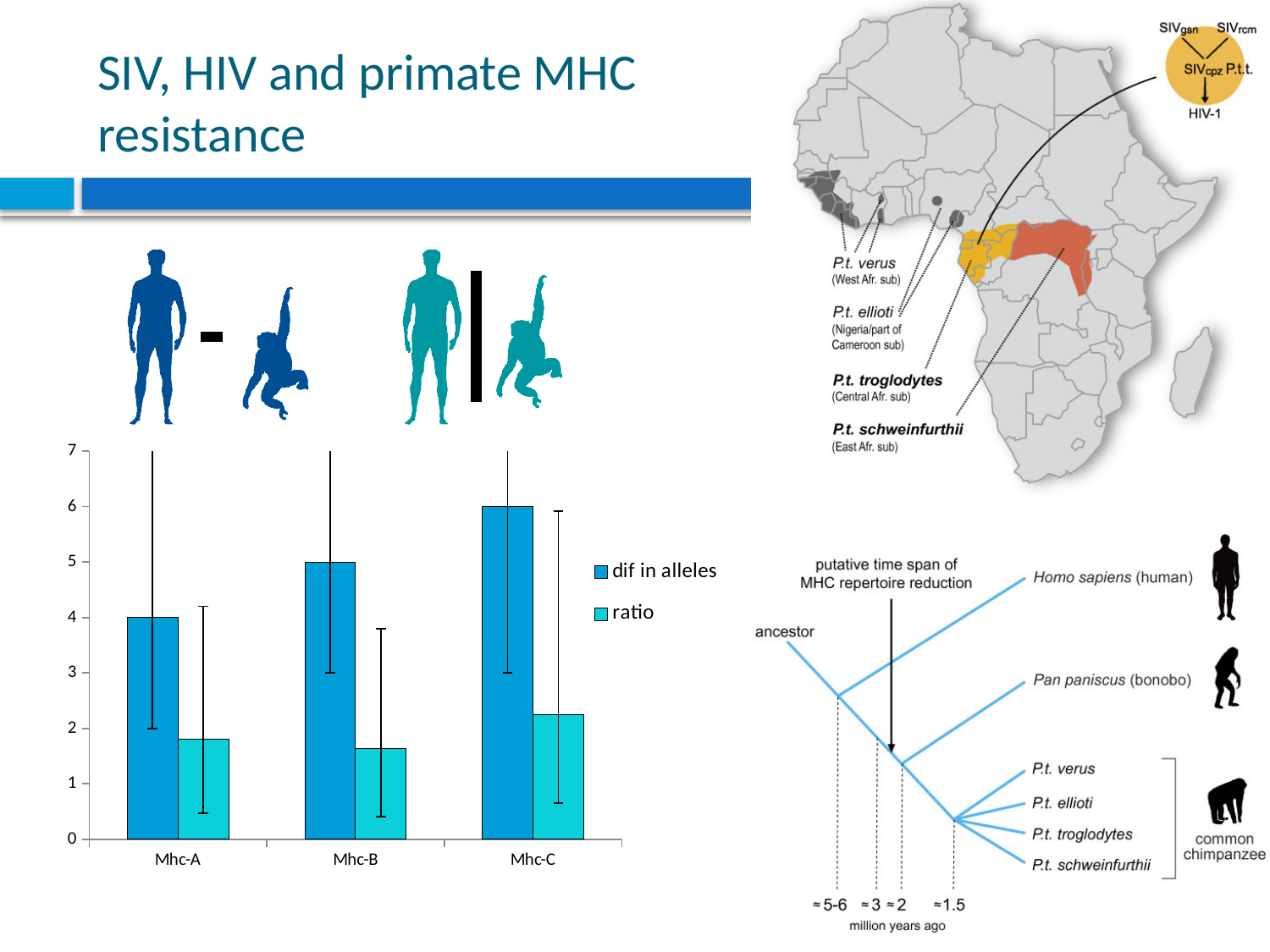
Which category has the lowest 'dif in alleles' value? Mhc-A Which category has the highest 'dif in alleles' value? Mhc-C What is the difference between the 'dif in alleles' values for Mhc-C and Mhc-A? 2 What kind of chart is shown on the left of the slide? bar chart How many categories are shown on the x axis of the bar chart? 3 Do the 'dif in alleles' values rise or fall from Mhc-A to Mhc-C? rise Is the 'ratio' value for Mhc-A greater or less than 2? less For Mhc-B, which series has the larger value, 'dif in alleles' or 'ratio'? dif in alleles How many series does the legend of the bar chart list? 2 What is the value of 'dif in alleles' for Mhc-C? 6 What is the value of 'dif in alleles' for Mhc-A? 4 Is the 'ratio' value for Mhc-C greater or less than 3? less